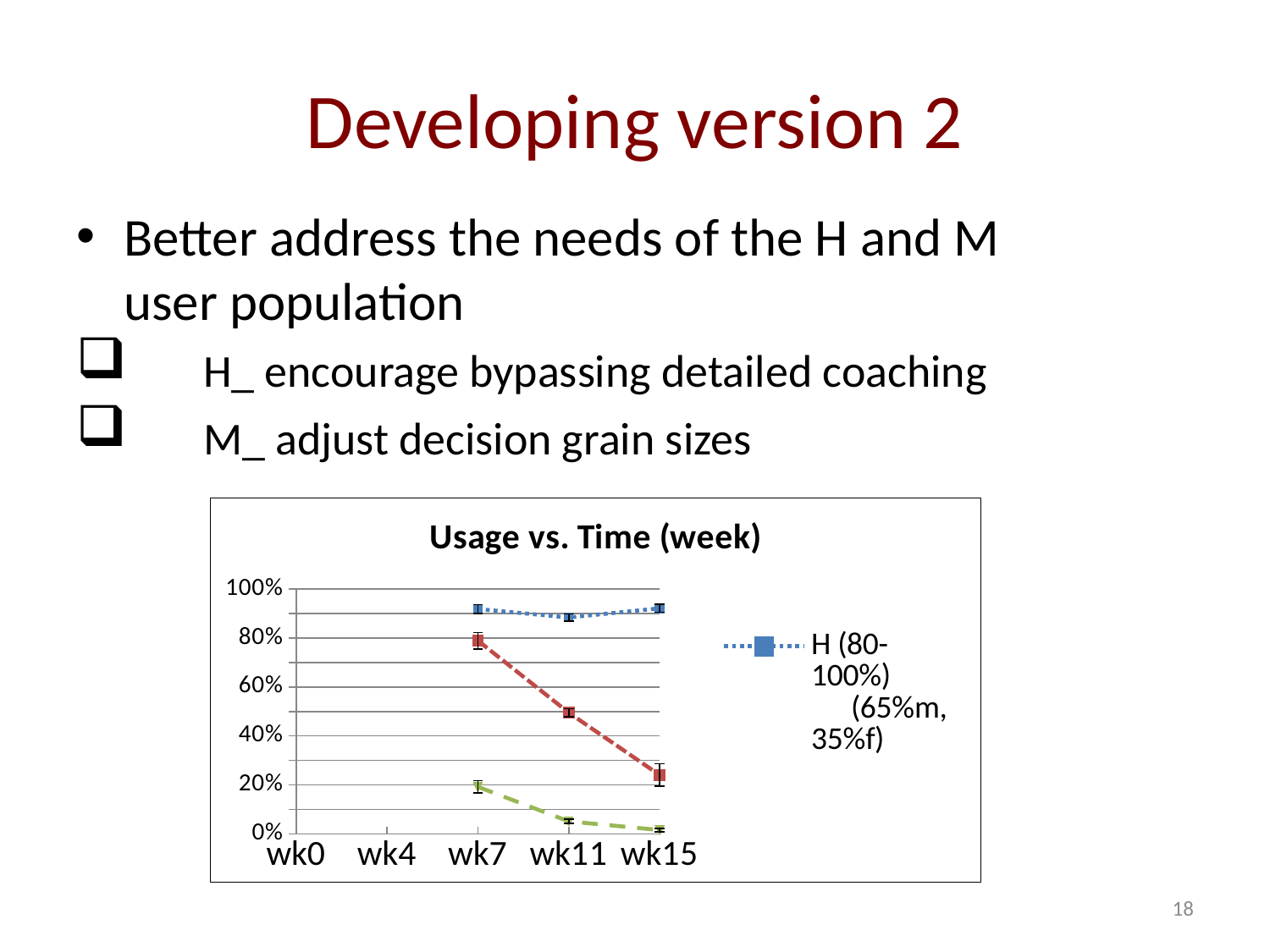
Is the value of the H (80-100%) series at wk11 greater or less than 80%? greater What kind of chart is shown on the slide? line chart What is the legend entry shown for the chart? H (80-100%) (65%m, 35%f) How many week labels are shown on the x axis of the chart? 5 Is the value of the H (80-100%) series at wk7 greater or less than 80%? greater At wk11, which is larger: the H (80-100%) series or the red dashed line? H (80-100%) What is the title of the chart? Usage vs. Time (week) Is the value of the red dashed line at wk7 greater or less than 60%? greater Does the red dashed line rise or fall from wk7 to wk15? fall How many series does the chart's legend list? 1